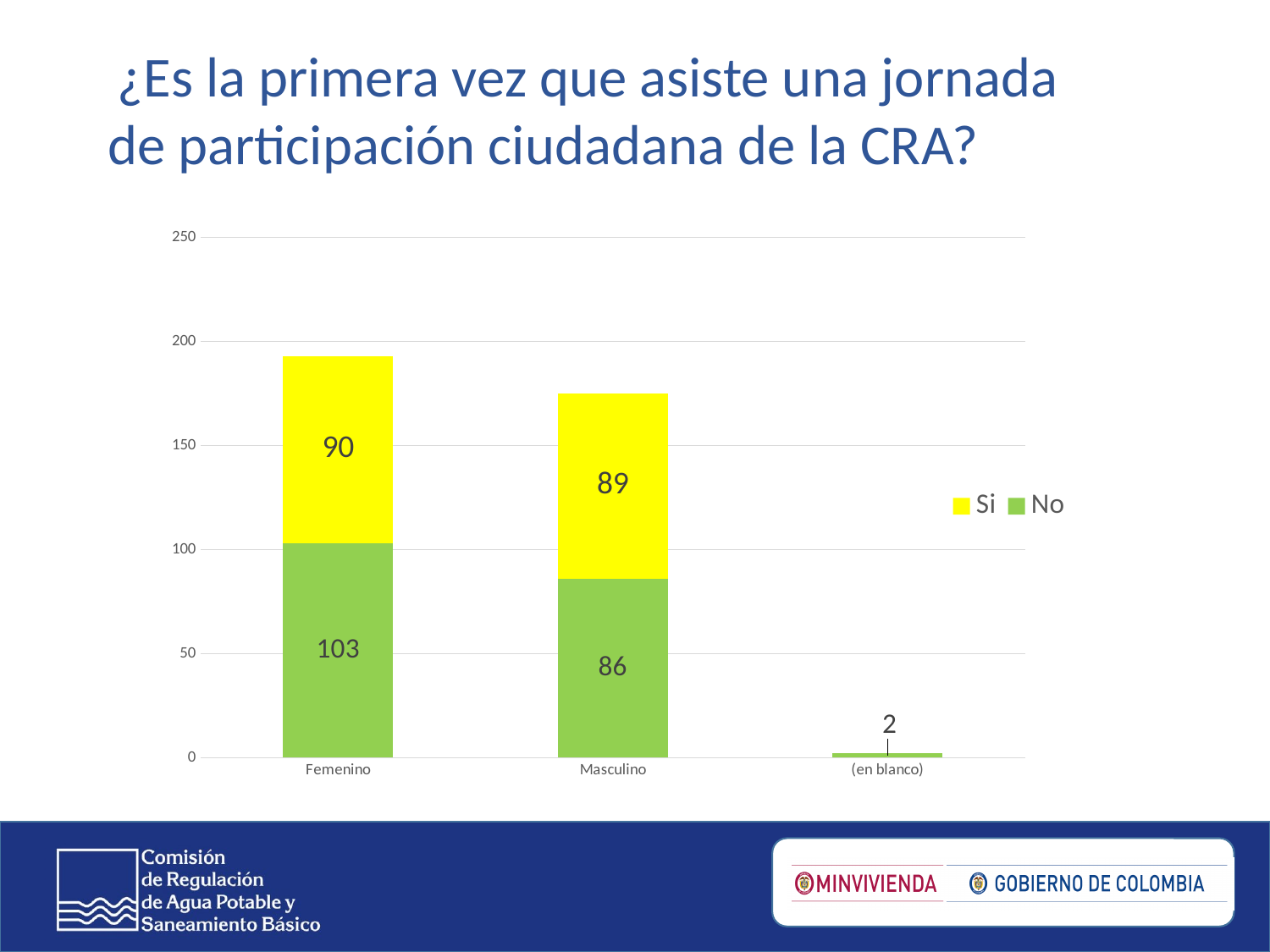
What is the difference between the "No" values for Femenino and Masculino? 17 How many categories are shown on the x axis? 3 What is the total of the stacked bar for Masculino? 175 Which category has the lowest value for the "No" series? (en blanco) What is the value of the "No" series for Femenino? 103 What is the total of the stacked bar for Femenino? 193 How many series does the legend list? 2 What is the value of the "No" series for Masculino? 86 What is the value of the "Si" series for Masculino? 89 What is the value of the "Si" series for Femenino? 90 Which is larger, the "Si" value for Femenino or the "No" value for Femenino? No (103) What kind of chart is shown on the slide? Stacked bar chart